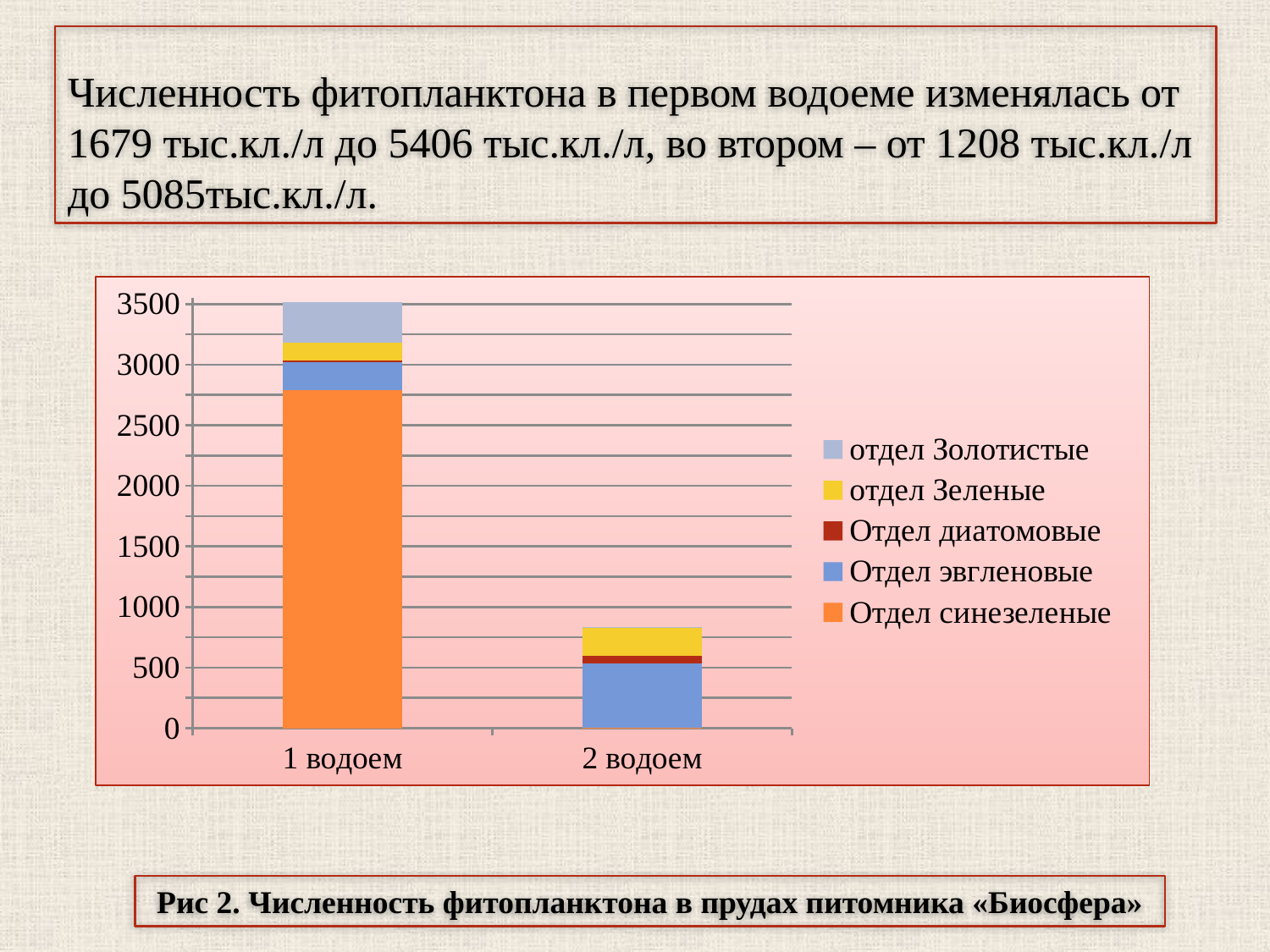
What is the caption of the figure below the chart? Рис 2. Численность фитопланктона в прудах питомника «Биосфера» Do the total stacked values rise or fall from 1 водоем to 2 водоем? fall Which category has the taller stacked bar, 1 водоем or 2 водоем? 1 водоем What kind of chart is shown on the slide? stacked bar chart Is the value of Отдел синезеленые for 1 водоем greater or less than 2500? greater Is the total stacked value for 1 водоем greater or less than 3000? greater How many series does the chart legend list? 5 Is the value of Отдел эвгленовые for 2 водоем greater or less than 1000? less Which series is shown in orange in the chart legend? Отдел синезеленые How many categories are shown on the x axis of the chart? 2